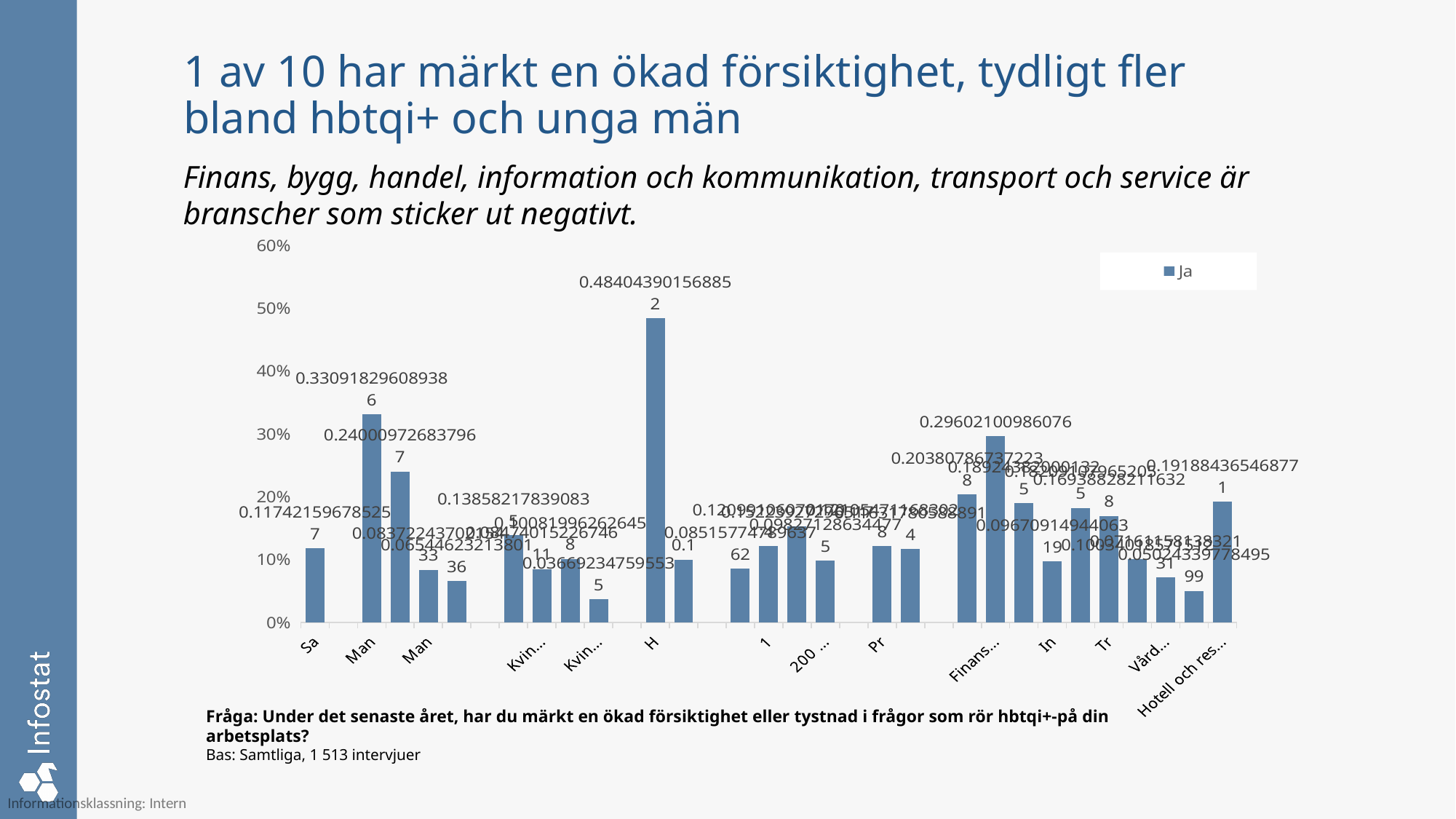
Is the value for H greater or less than 40%? greater What is the highest value shown on the vertical axis? 60% Which is larger, the first bar labelled Man or the second bar labelled Man? the first bar labelled Man What is the name of the series shown in the legend? Ja Is the value for Finans... greater or less than 10%? greater How many series does the legend list? 1 Which category has the highest bar in the chart? H What value is printed above the bar for H? 0.48404390156885 Which is larger, the value for Sa or the value for H? H What kind of chart is shown on the slide? bar chart Is the value for Sa greater or less than 10%? greater